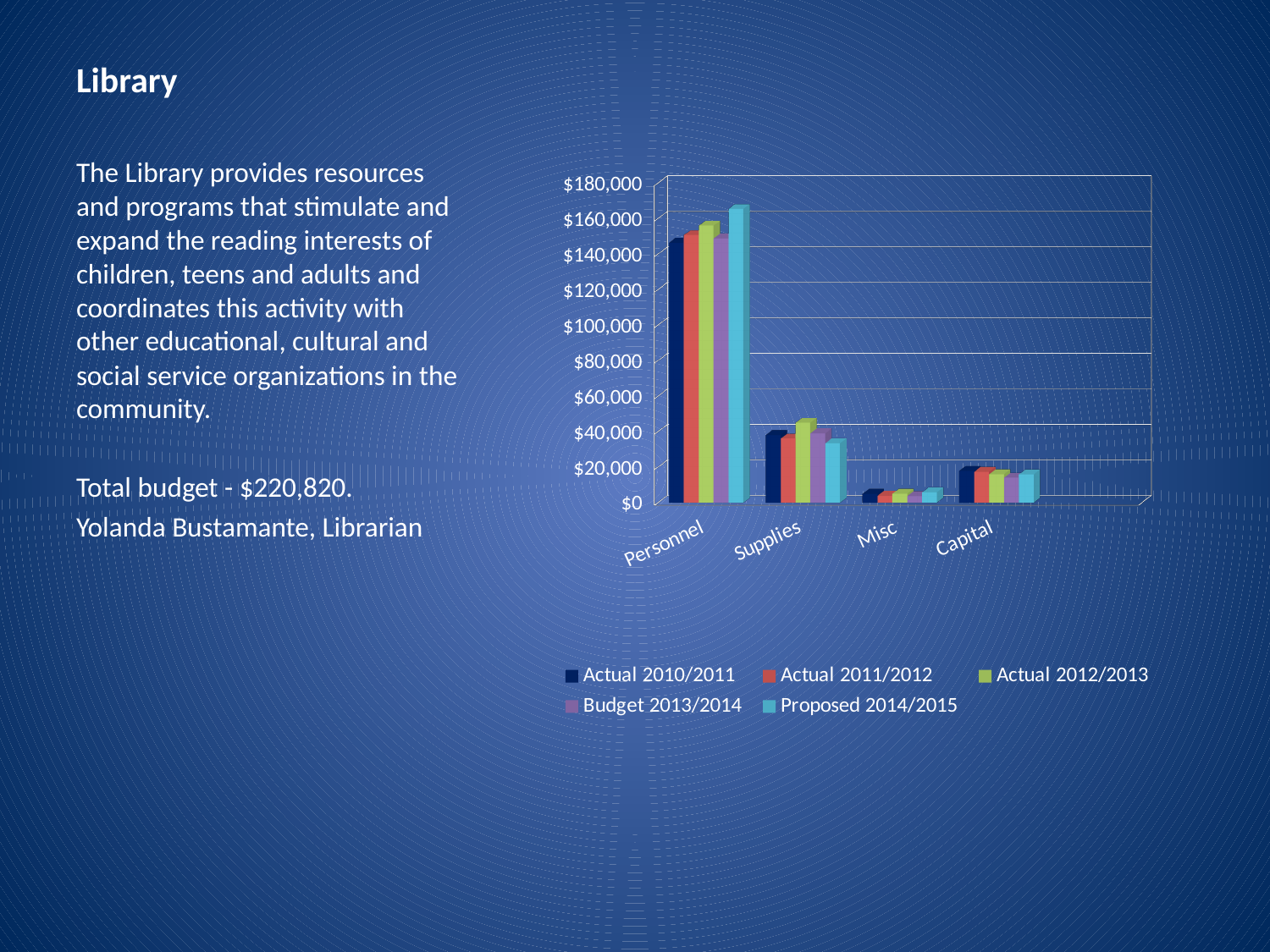
Is the Actual 2010/2011 value for Capital greater or less than $40,000? less Is the Proposed 2014/2015 value for Personnel greater or less than $140,000? greater Which category has the lowest values in the chart? Misc Is the Actual 2012/2013 value for Supplies greater or less than $20,000? greater How many series does the chart legend list? 5 Which category has the highest values in the chart? Personnel What kind of chart is shown on the slide? Bar chart For the Proposed 2014/2015 series, which is larger: Personnel or Supplies? Personnel What is the last series listed in the chart legend? Proposed 2014/2015 How many categories are shown on the x axis of the chart? 4